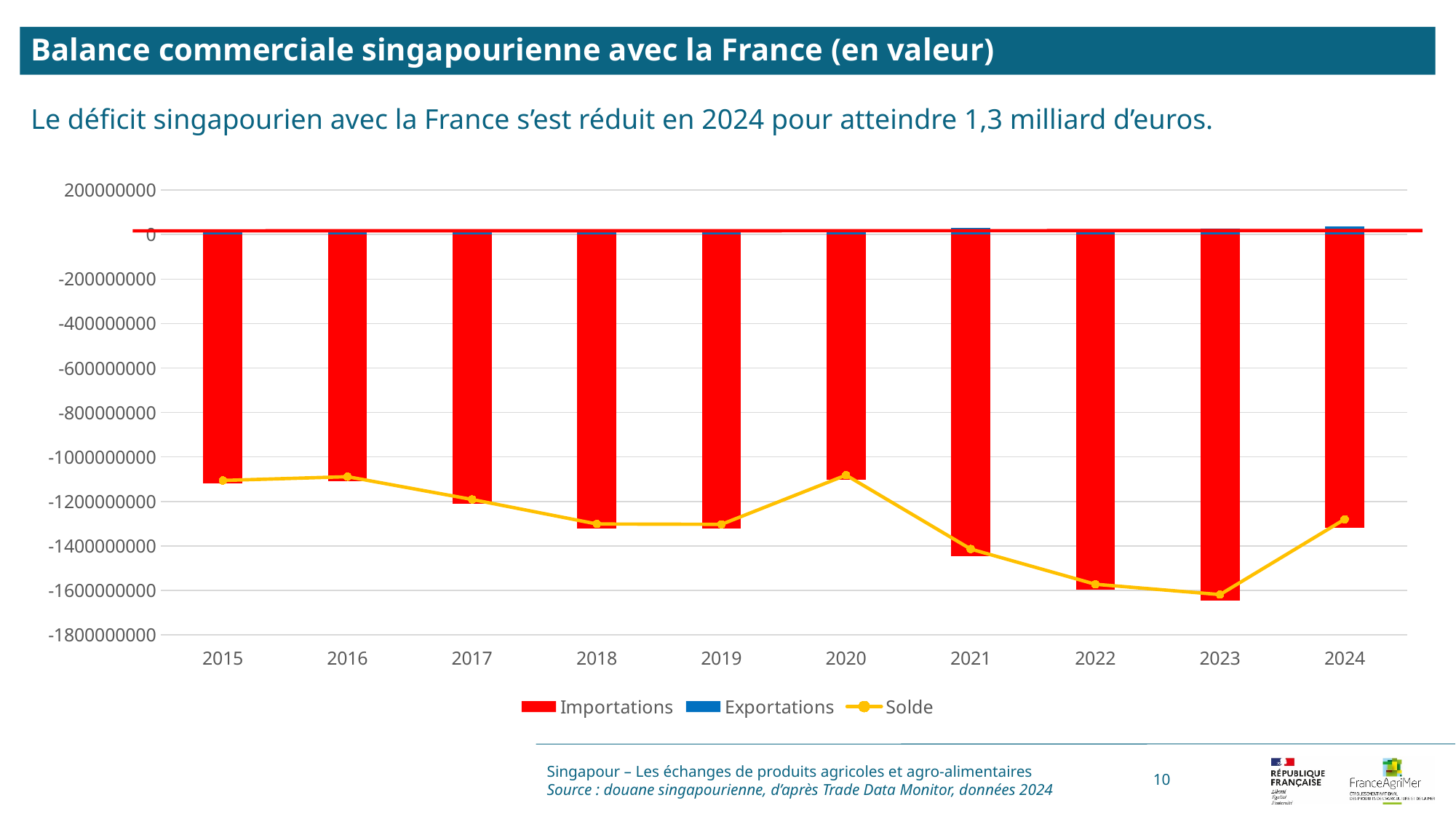
In which year is the Solde line at its lowest point? 2023 Is the Importations value for 2023 greater or less than -1600000000? less What kind of chart is shown on the slide? A bar chart combined with a line Which year has the larger Solde value, 2020 or 2021? 2020 Which series is shown with red bars? Importations Is the Solde value for 2022 greater or less than -1400000000? less How many series does the legend list? 3 How many years are shown on the x axis? 10 Does the Solde line rise or fall from 2020 to 2023? fall In which year does the Importations bar extend furthest below zero? 2023 Is the Solde value for 2024 greater or less than -1400000000? greater Which series is drawn as a yellow line with markers? Solde